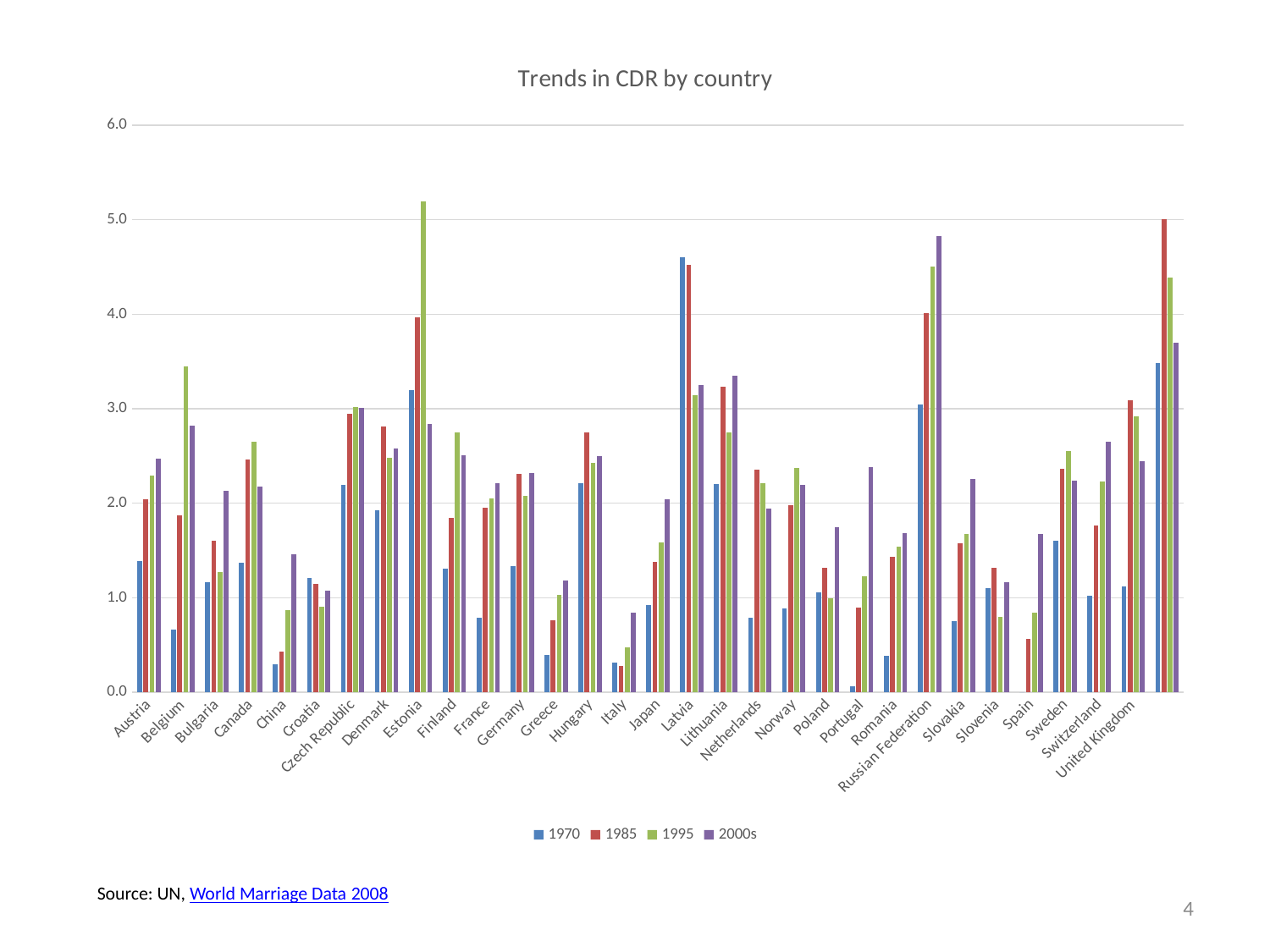
Which country has the highest value for the 1995 series? Estonia What kind of chart is shown on the slide? bar chart Which country has the highest value for the 1970 series? Latvia For Latvia, which is larger: the 1970 value or the 2000s value? 1970 What is the title of the chart? Trends in CDR by country Is the 1995 value for Estonia greater or less than 5.0? greater How many countries are shown on the x axis? 30 How many series does the legend list? 4 Is the 1970 value for China greater or less than 1.0? less For Portugal, do the values rise or fall from the 1970 series to the 2000s series? rise Which country has the highest value for the 2000s series? Russian Federation